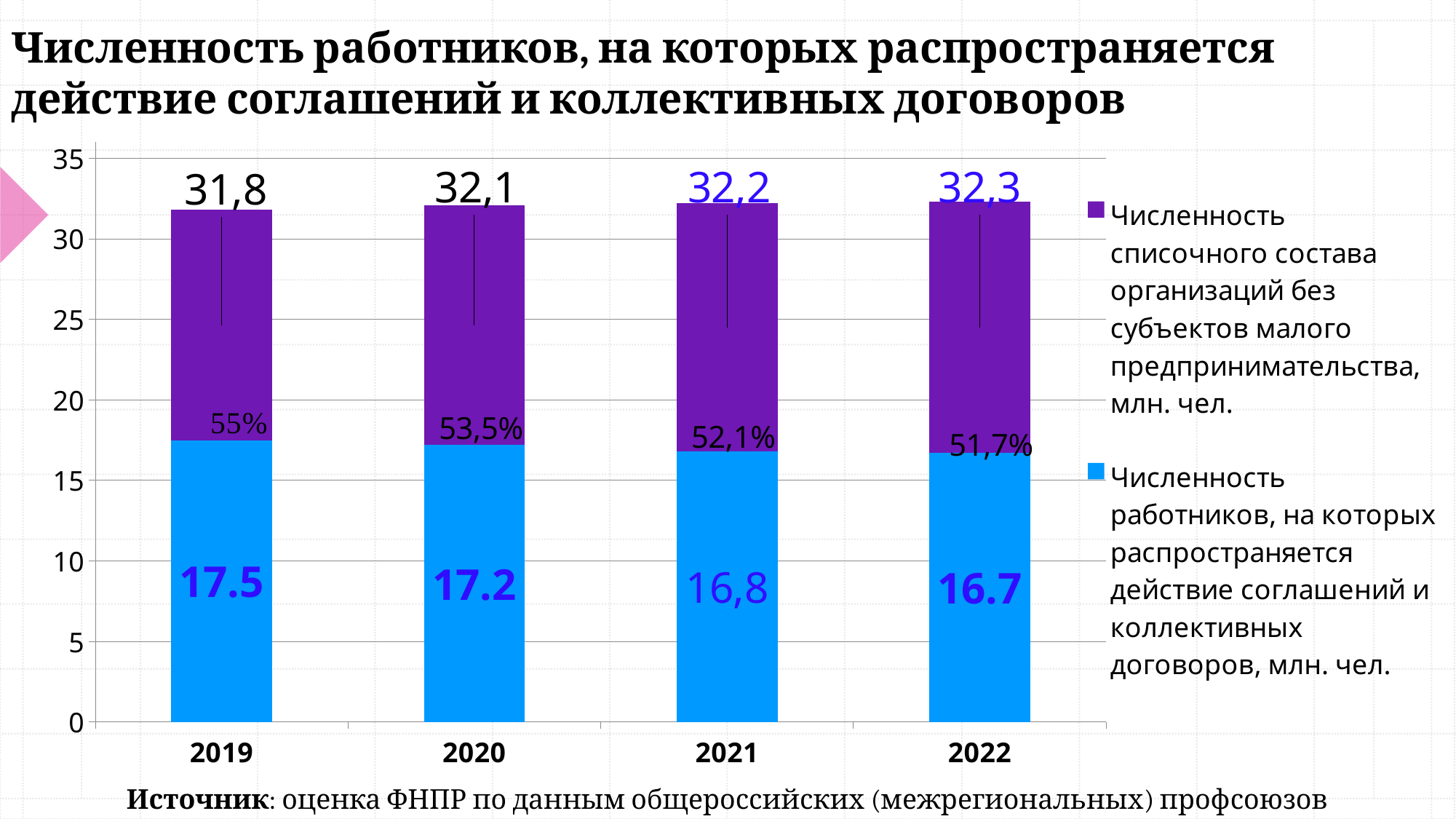
Which year has the highest value for the blue series (workers covered by agreements)? 2019 How does the blue series (workers covered by agreements) change from 2019 to 2022? It falls What percentage is printed on the bar for 2020? 53,5% How many years are shown on the x axis? 4 What is the difference between the blue series values for 2019 and 2022? 0.8 What is the value of the blue series (workers covered by agreements and collective contracts) for 2019? 17.5 How many series does the legend list? 2 What value is printed at the top of the bar for 2021? 32,2 Which year has the lowest value for the blue series (workers covered by agreements)? 2022 What is the value of the blue series (workers covered by agreements and collective contracts) for 2022? 16.7 What kind of chart is shown on the slide? Stacked bar chart Which is larger: the value printed at the top of the 2019 bar or the 2022 bar? 2022